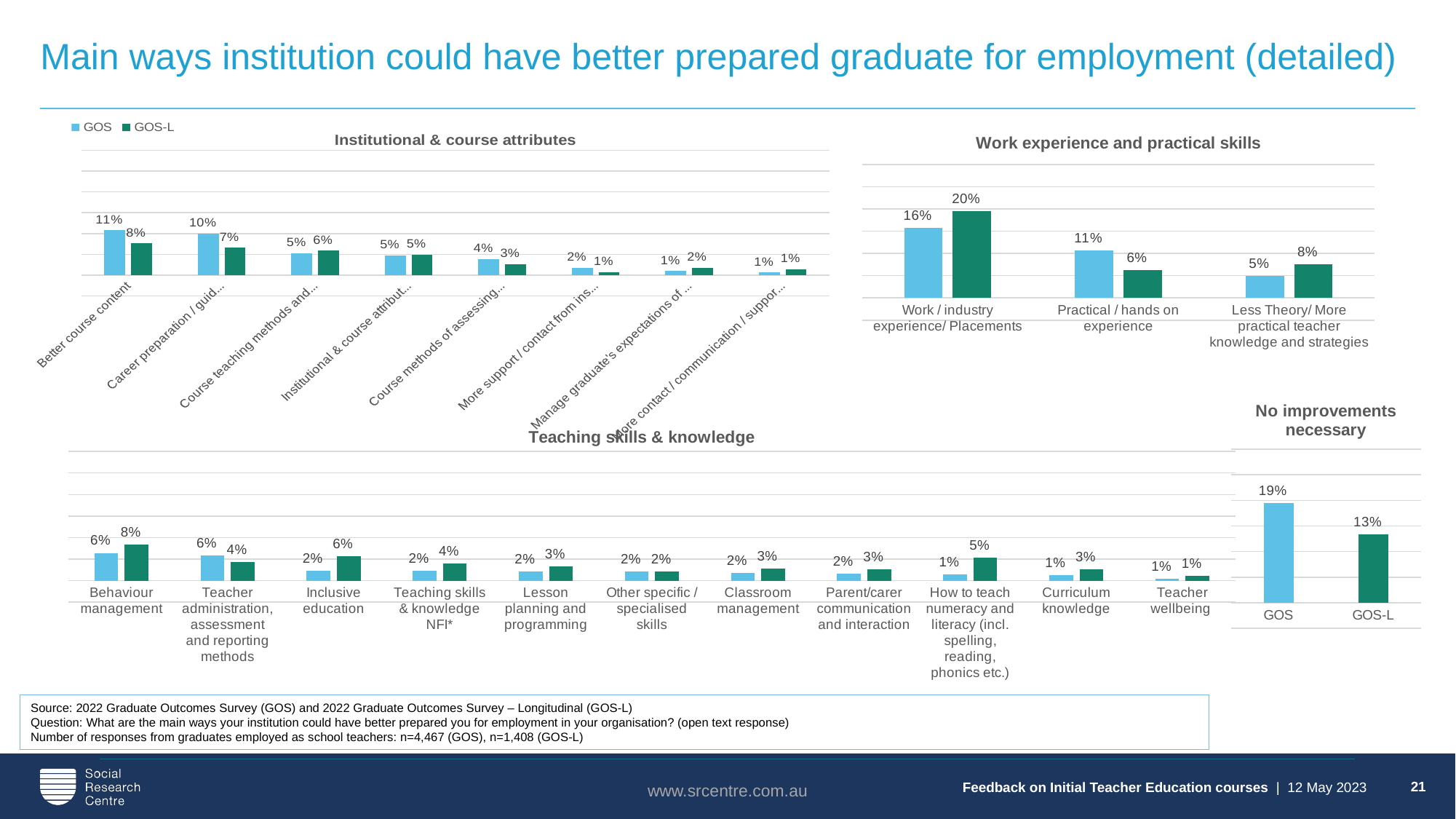
How many series does the legend list? 2 In the 'Teaching skills & knowledge' chart, what is the GOS-L value for How to teach numeracy and literacy (incl. spelling, reading, phonics etc.)? 5% What type of chart is the 'Work experience and practical skills' chart? Bar chart In the 'No improvements necessary' chart, what is the difference between the GOS and GOS-L values? 6% In the 'No improvements necessary' chart, what is the value for GOS? 19% In the 'Teaching skills & knowledge' chart, which category has the highest GOS-L value? Behaviour management In the 'Work experience and practical skills' chart, what is the GOS-L value for Work / industry experience/ Placements? 20% In the 'Work experience and practical skills' chart, what is the GOS value for Practical / hands on experience? 11% In the 'Institutional & course attributes' chart, what is the GOS value for Better course content? 11% How many categories are shown in the 'Teaching skills & knowledge' chart? 11 In the 'Teaching skills & knowledge' chart, which is larger for Inclusive education: the GOS value or the GOS-L value? GOS-L In the 'Work experience and practical skills' chart, what is the difference between the GOS-L and GOS values for Less Theory/ More practical teacher knowledge and strategies? 3%